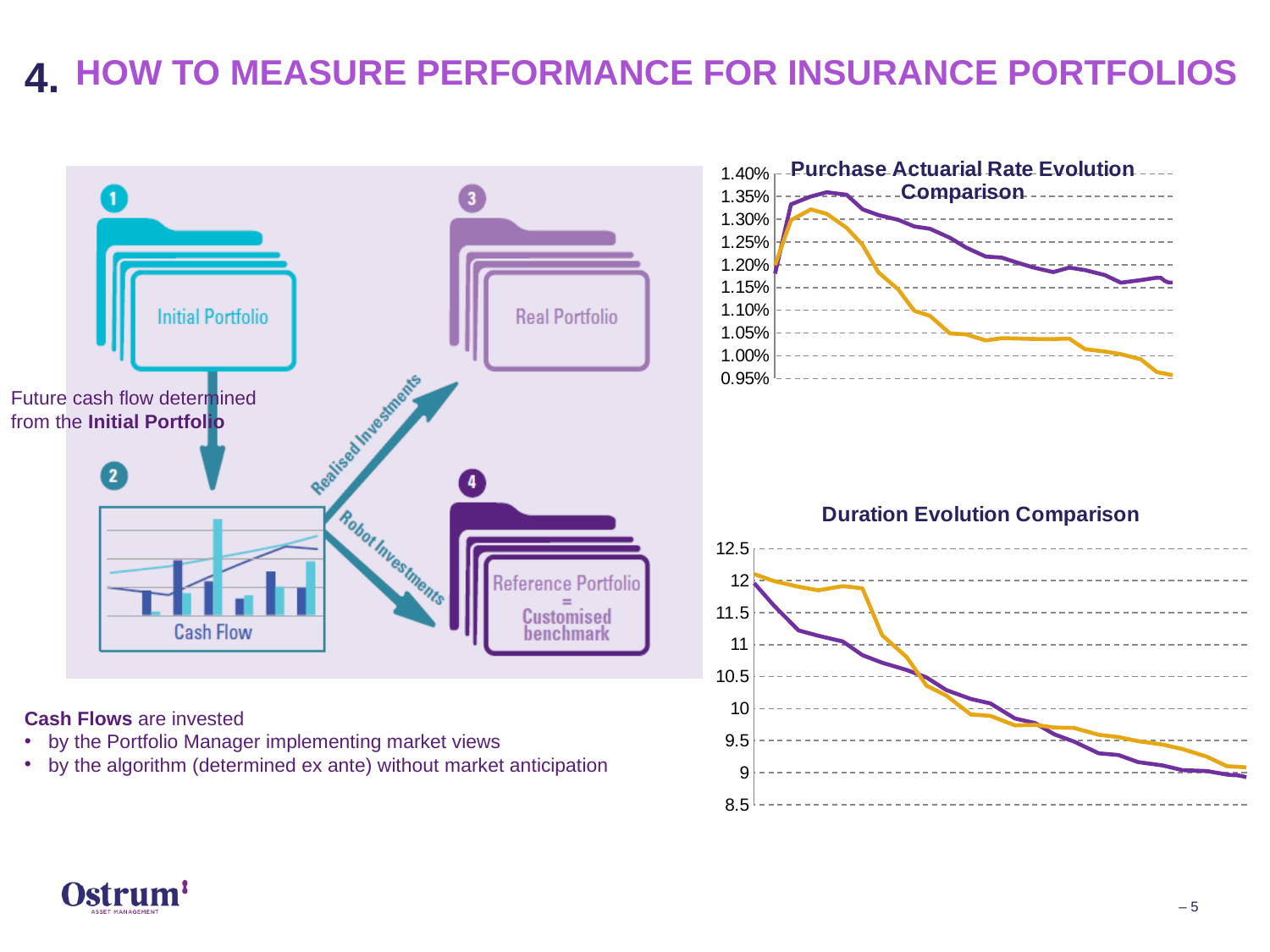
In the "Purchase Actuarial Rate Evolution Comparison" chart, is the final value of the yellow line greater or less than 1.00%? less In the "Purchase Actuarial Rate Evolution Comparison" chart, after the initial peak, do the lines rise or fall along the x axis? fall What kind of chart is the "Purchase Actuarial Rate Evolution Comparison" chart? line chart In the "Duration Evolution Comparison" chart, is the final value of the purple line greater or less than 9.5? less In the "Purchase Actuarial Rate Evolution Comparison" chart, which line ends higher, the purple line or the yellow line? the purple line What is the lowest value shown on the y axis of the "Duration Evolution Comparison" chart? 8.5 How many lines are plotted in the "Duration Evolution Comparison" chart? 2 What kind of chart is the "Duration Evolution Comparison" chart? line chart What is the highest value shown on the y axis of the "Purchase Actuarial Rate Evolution Comparison" chart? 1.40% In the "Duration Evolution Comparison" chart, do the values generally rise or fall along the x axis? fall In the "Purchase Actuarial Rate Evolution Comparison" chart, is the peak value of the yellow line greater or less than 1.30%? greater